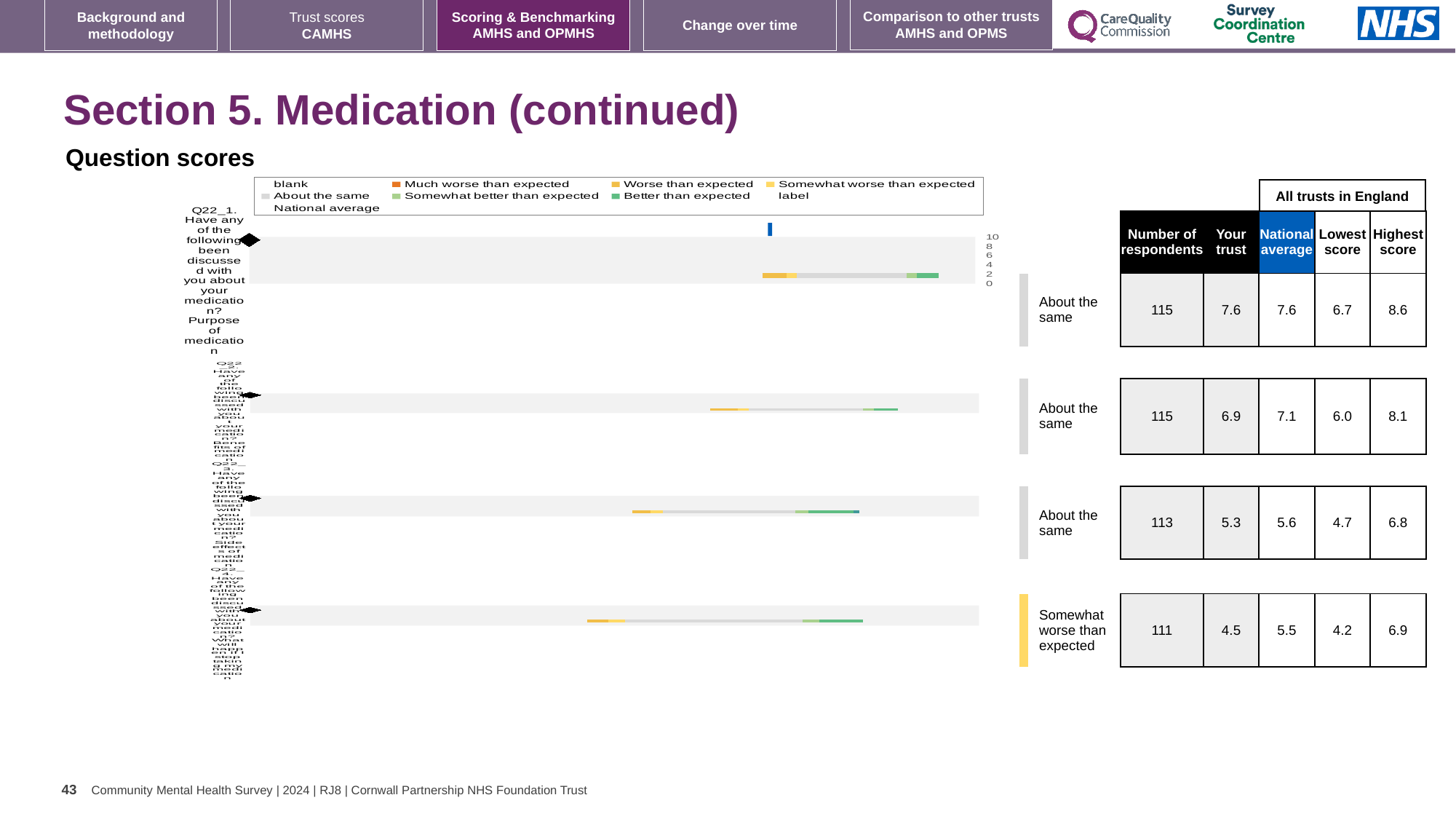
How many entries does the chart's legend list? 9 What is the highest tick value shown on the chart's score axis? 10 What kind of chart is shown under the 'Question scores' heading? bar chart How many question categories (bars) are plotted in the chart? 4 Which question is plotted as the topmost bar in the chart? Q22_1 (Purpose of medication) Which colour does the legend use for 'Better than expected'? green